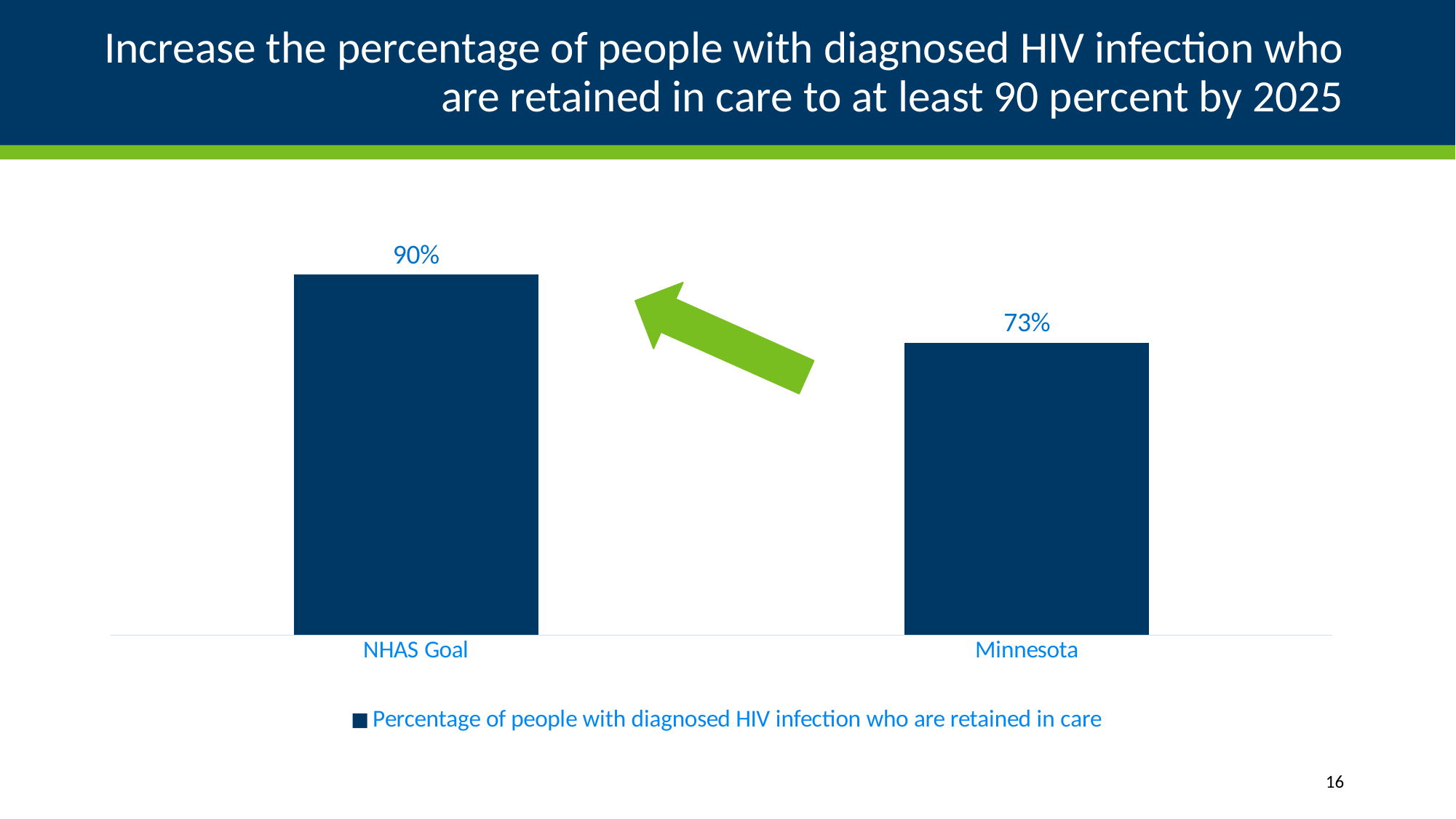
Which category has the lowest value? Minnesota How many series does the legend list? 1 What is the value for Minnesota? 73% Which is larger, the value for NHAS Goal or the value for Minnesota? NHAS Goal What colour are the bars in the chart? Dark blue How many categories are shown on the chart? 2 What is the legend entry for the series shown? Percentage of people with diagnosed HIV infection who are retained in care What is the value for NHAS Goal? 90% What kind of chart is shown on the slide? Bar chart What is the difference between the NHAS Goal value and the Minnesota value? 17% Which category has the highest value? NHAS Goal